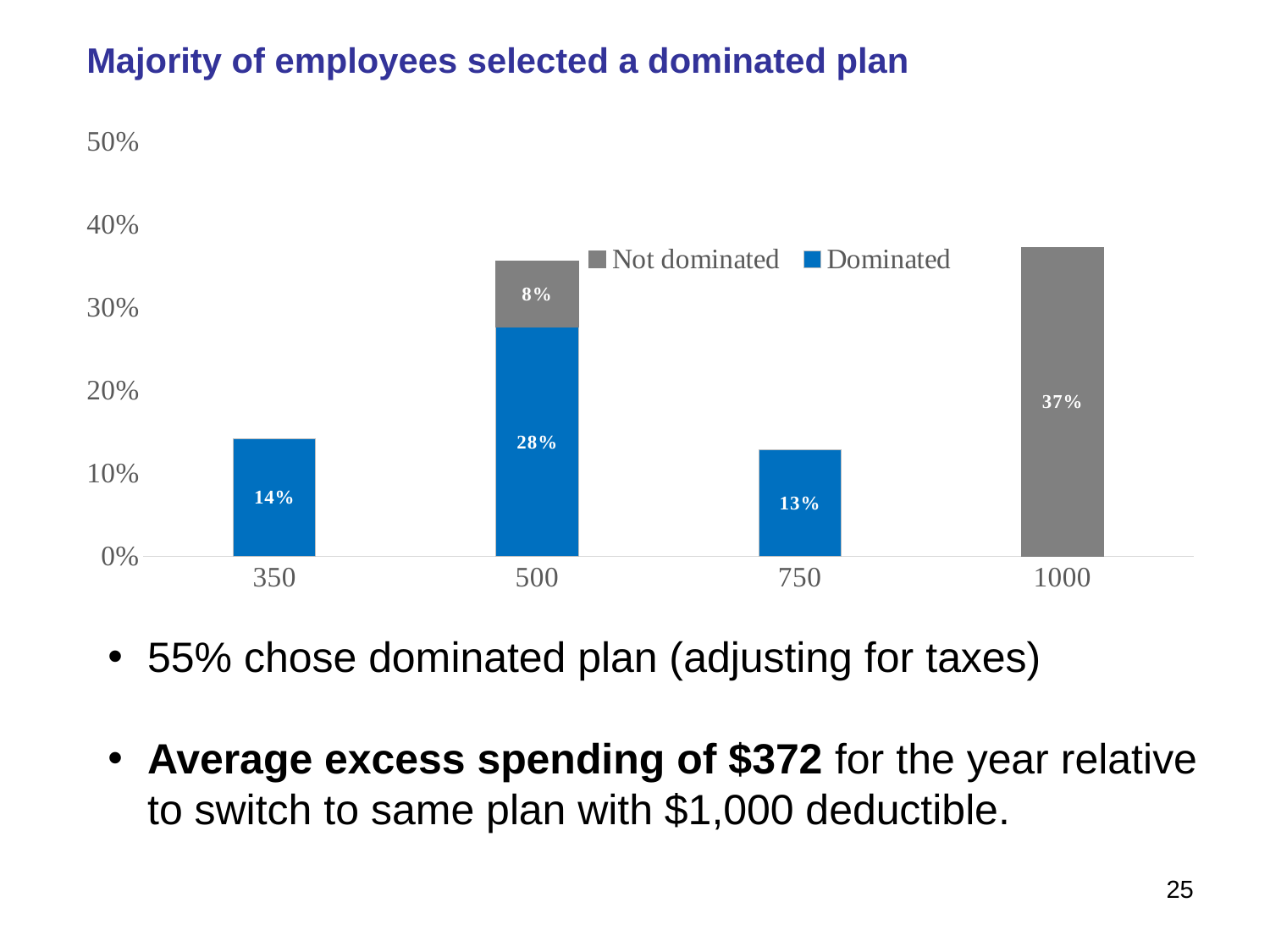
How many series does the legend list? 2 What is the Not dominated value for the 500 category? 8% What is the difference between the Dominated values for 500 and 750? 15% What is the total height of the stacked bar for the 500 category? 36% How many categories are shown on the x axis? 4 What kind of chart is shown on the slide? stacked bar chart What is the Dominated value for the 350 category? 14% Which category has the highest Dominated value? 500 Is the Dominated value for 350 larger or smaller than the Dominated value for 750? larger What is the Dominated value for the 500 category? 28% Which category has the lowest Dominated value among those with a Dominated bar? 750 What is the Not dominated value for the 1000 category? 37%